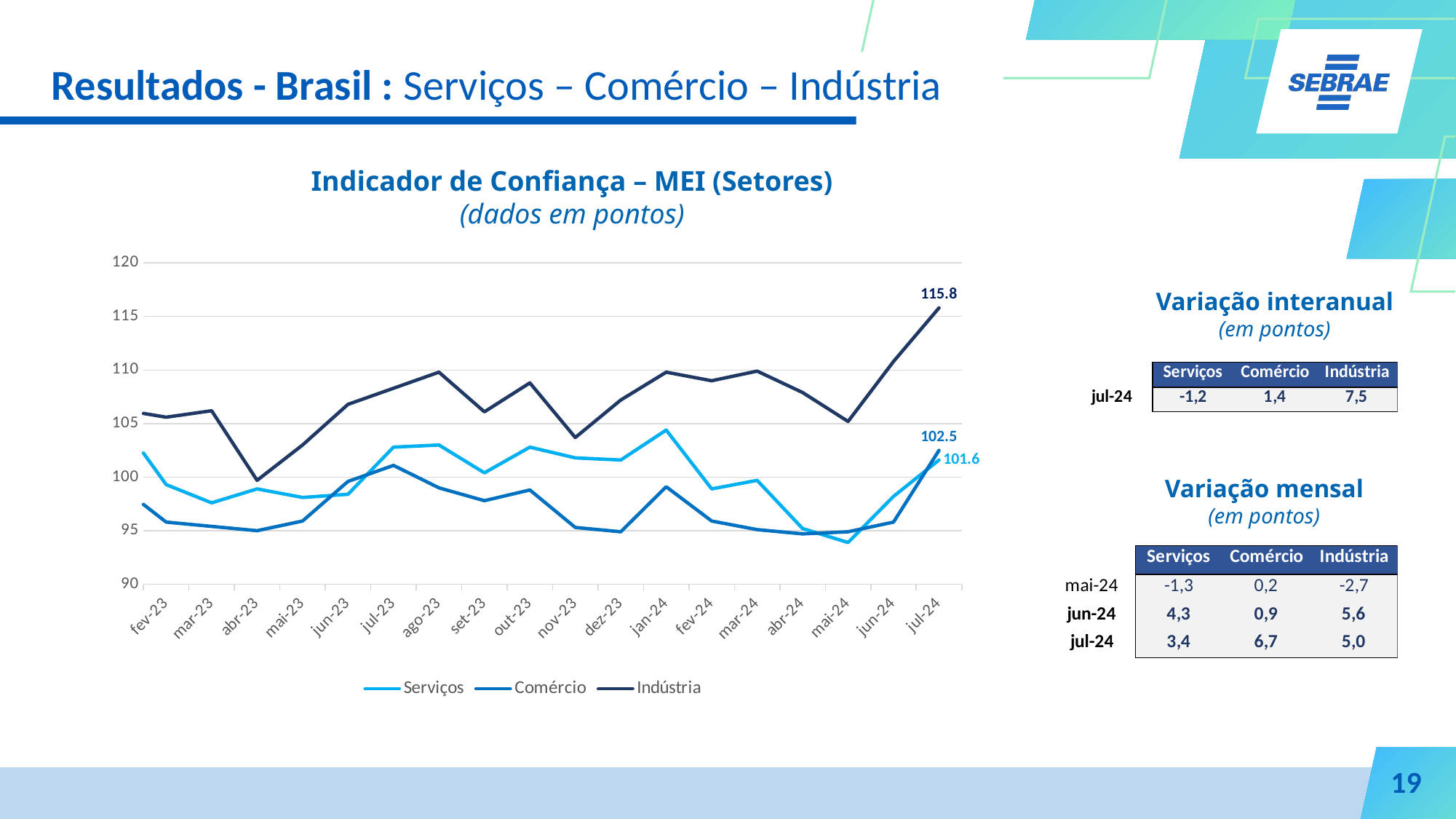
What is the value of Comércio in jul-24 on the chart? 102.5 Is the value for Comércio in jan-24 greater or less than 100? less What is the value of Serviços in jul-24 on the chart? 101.6 Which series has the highest value in jul-24 on the chart? Indústria What is the value of Indústria in jul-24 on the Indicador de Confiança – MEI (Setores) chart? 115.8 Is the value for Indústria in nov-23 greater or less than 100? greater In jul-24, which is larger: the Indústria value or the Serviços value? Indústria How many series does the chart's legend list? 3 What kind of chart is shown on the slide? Line chart What is the difference between the Indústria and Comércio values in jul-24? 13.3 What is the difference between the Comércio and Serviços values in jul-24? 0.9 How many months are plotted on the x axis of the chart? 18